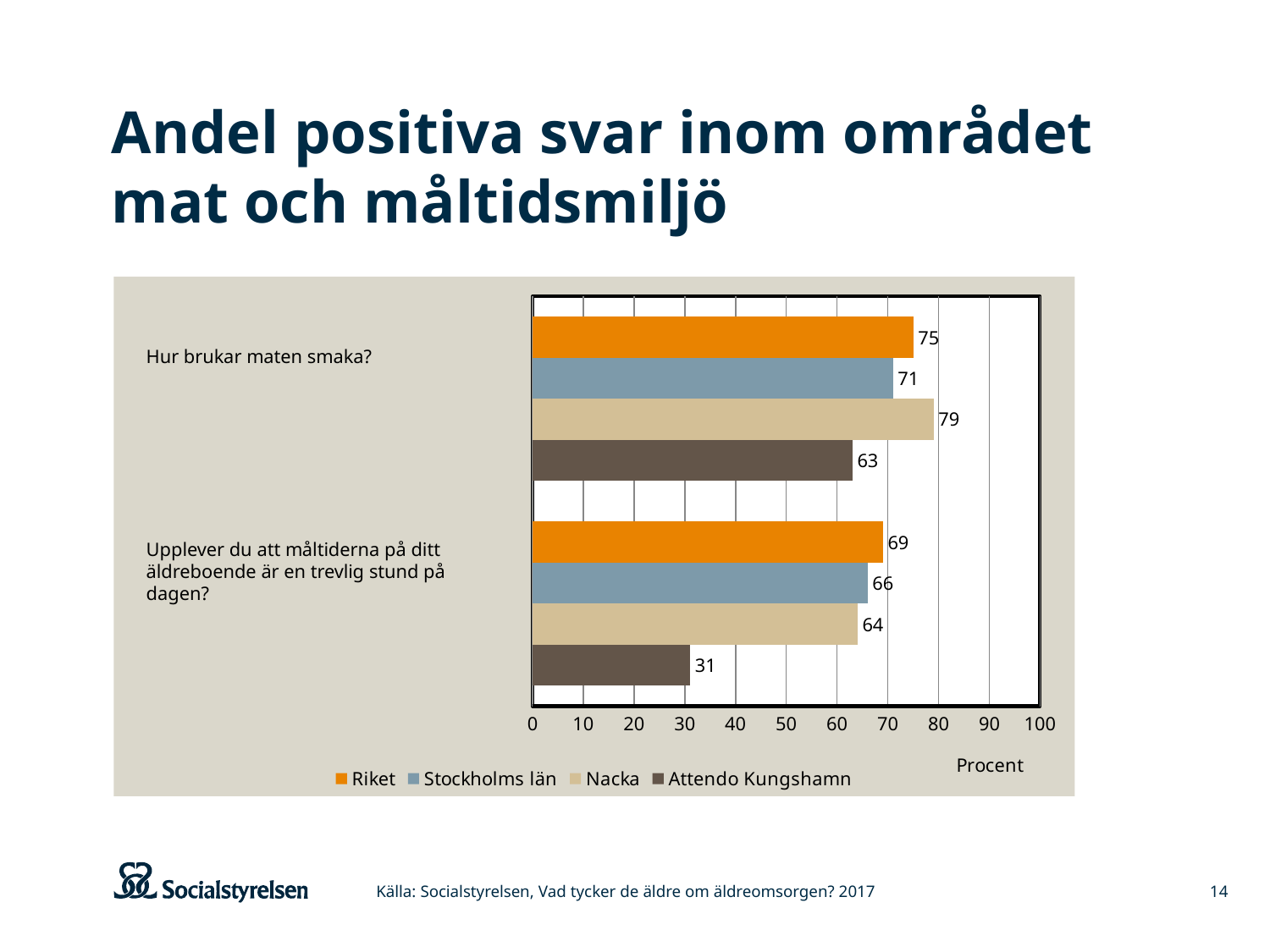
What value is shown for Riket on the question "Hur brukar maten smaka?"? 75 What value is shown for Stockholms län on the question "Upplever du att måltiderna på ditt äldreboende är en trevlig stund på dagen?"? 66 What value is shown for Nacka on the question "Hur brukar maten smaka?"? 79 What kind of chart is shown on the slide? Bar chart Which series has the highest value for "Hur brukar maten smaka?"? Nacka For "Hur brukar maten smaka?", which is larger: the value for Riket or the value for Stockholms län? Riket What is the difference between the Nacka and Attendo Kungshamn values for "Hur brukar maten smaka?"? 16 What value is shown for Attendo Kungshamn on the question "Upplever du att måltiderna på ditt äldreboende är en trevlig stund på dagen?"? 31 Which series has the lowest value for "Upplever du att måltiderna på ditt äldreboende är en trevlig stund på dagen?"? Attendo Kungshamn What is the difference between the Riket and Attendo Kungshamn values for "Upplever du att måltiderna på ditt äldreboende är en trevlig stund på dagen?"? 38 What is the label on the horizontal axis of the chart? Procent How many series does the legend list? 4